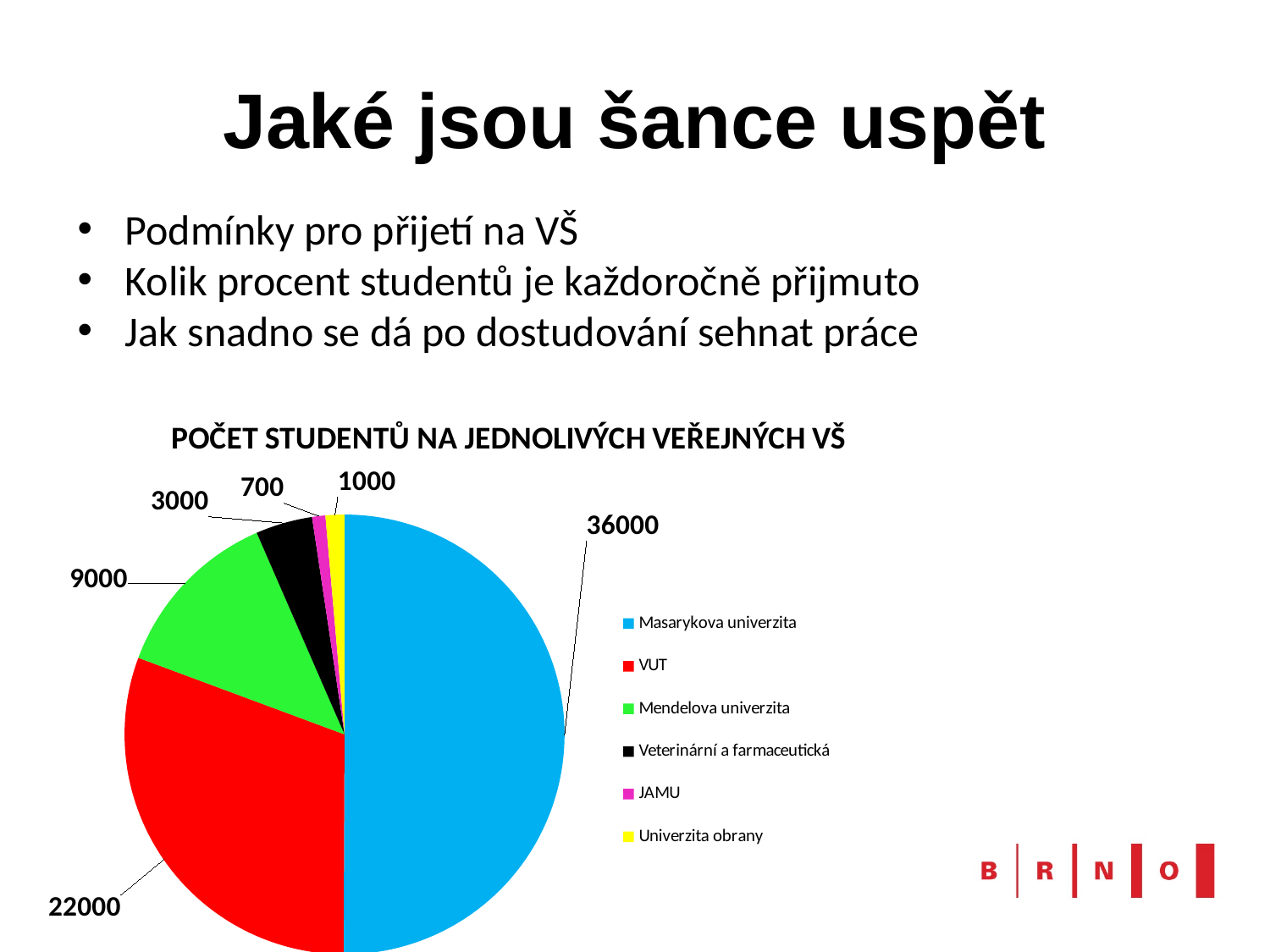
What type of chart is shown on the slide? pie chart How many entries does the legend list? 6 What is the title of the chart? POČET STUDENTŮ NA JEDNOLIVÝCH VEŘEJNÝCH VŠ Which university has the smallest slice? JAMU How many slices does the pie chart have? 6 What is the value for VUT? 22000 Which university has the largest slice? Masarykova univerzita What is the value for JAMU? 700 What is the difference between the values for Masarykova univerzita and VUT? 14000 Which is larger, the value for Univerzita obrany or the value for JAMU? Univerzita obrany What is the value for Masarykova univerzita? 36000 What is the value for Mendelova univerzita? 9000